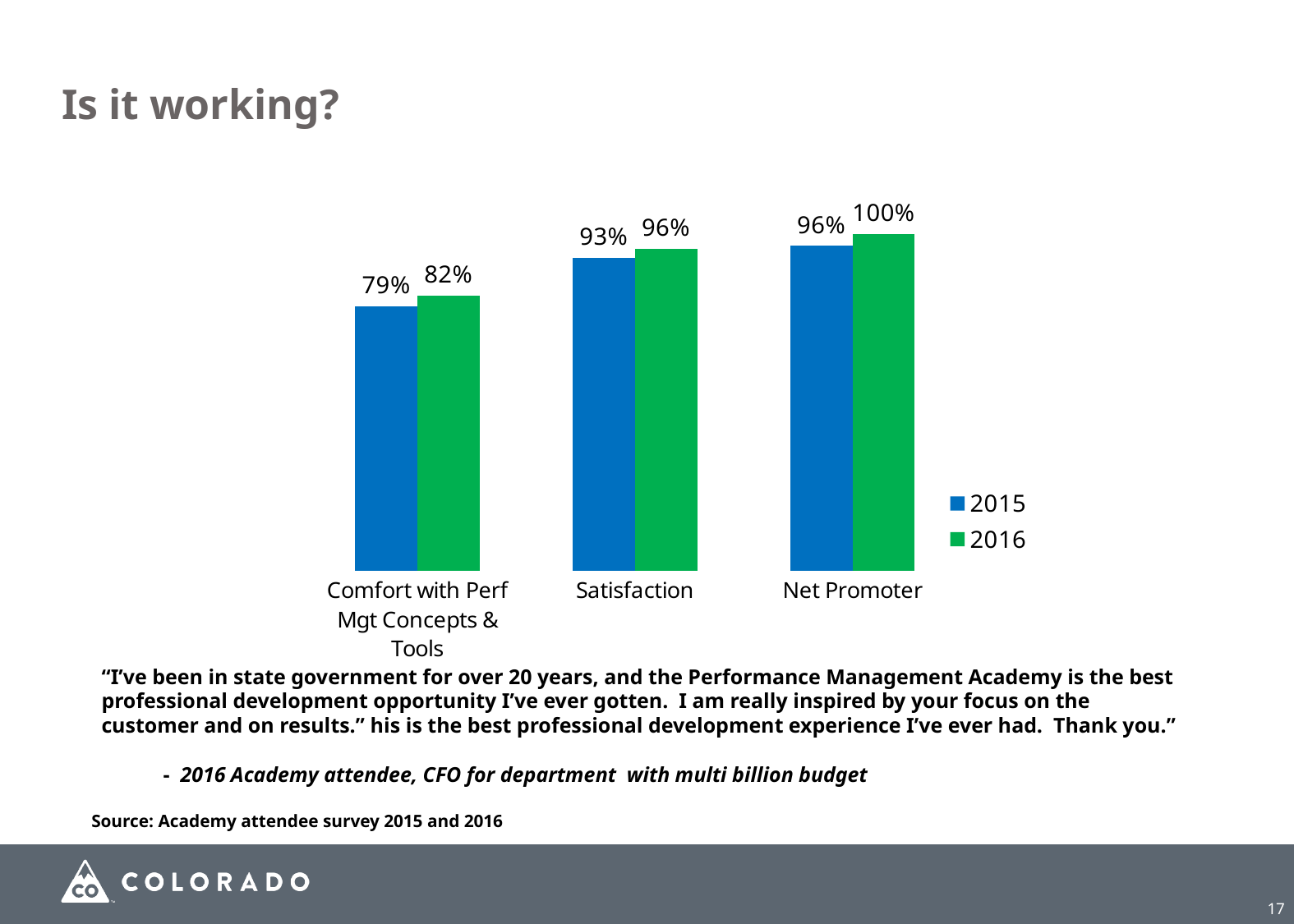
What is the 2015 value for Satisfaction? 93% What is the 2016 value for Comfort with Perf Mgt Concepts & Tools? 82% How many categories are shown on the x axis? 3 What is the difference between the 2016 and 2015 values for Comfort with Perf Mgt Concepts & Tools? 3% Which category has the lowest 2015 value? Comfort with Perf Mgt Concepts & Tools Which category has the highest 2016 value? Net Promoter What kind of chart is shown on the slide? Bar chart What is the 2015 value for Net Promoter? 96% Which is larger, the 2015 value for Satisfaction or the 2016 value for Comfort with Perf Mgt Concepts & Tools? 2015 value for Satisfaction How many series does the legend list? 2 What is the 2016 value for Net Promoter? 100% What is the difference between the 2016 and 2015 values for Net Promoter? 4%